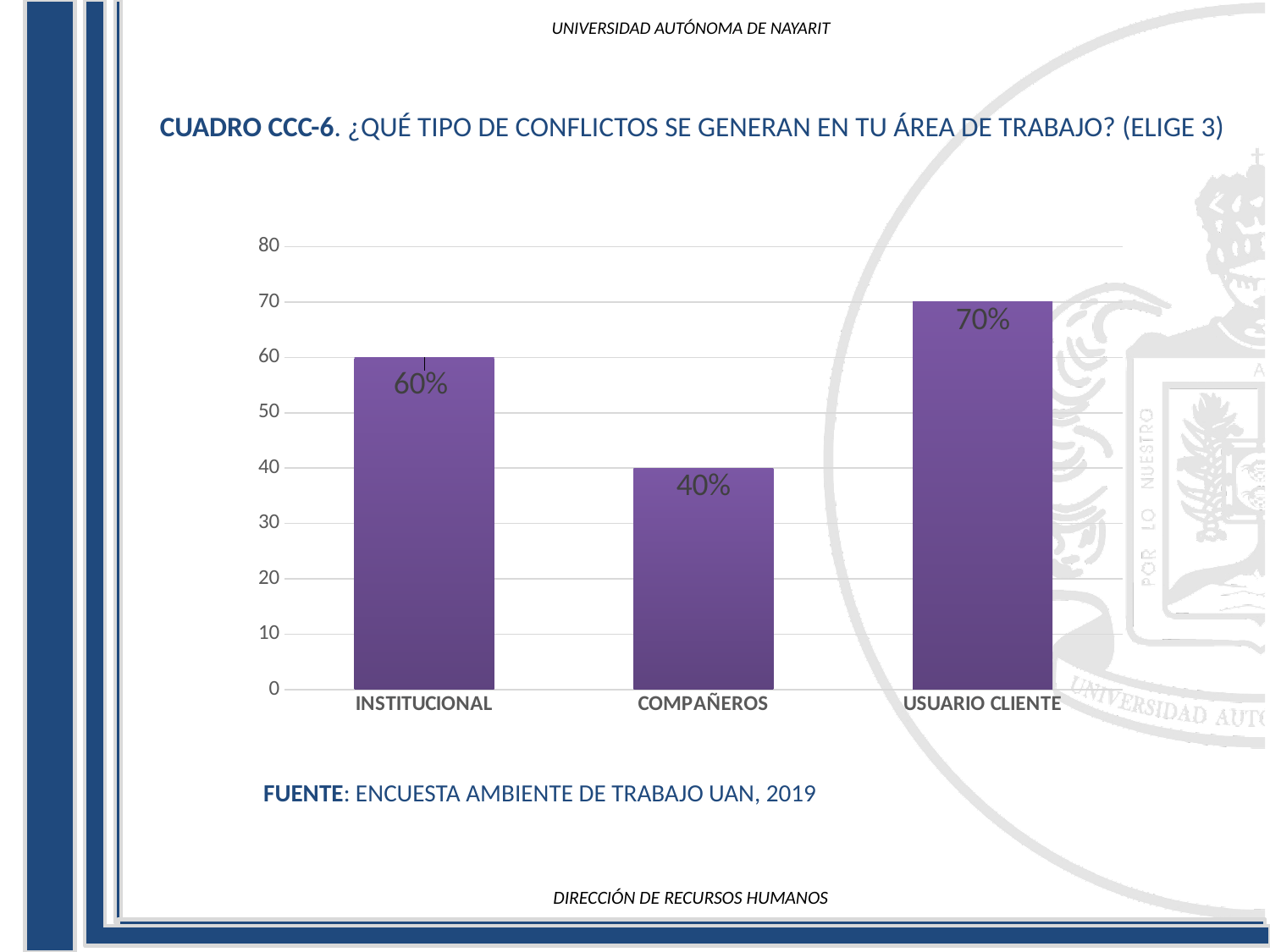
What is the value for COMPAÑEROS? 40% What is the value for INSTITUCIONAL? 60% How many categories are shown on the x axis? 3 What source is cited below the chart? ENCUESTA AMBIENTE DE TRABAJO UAN, 2019 Which category has the lowest value? COMPAÑEROS What kind of chart is shown on the slide? bar chart Which is larger, the value for INSTITUCIONAL or the value for USUARIO CLIENTE? USUARIO CLIENTE What is the difference between the values for INSTITUCIONAL and COMPAÑEROS? 20% Which category has the highest value? USUARIO CLIENTE What is the difference between the values for USUARIO CLIENTE and COMPAÑEROS? 30% What is the value for USUARIO CLIENTE? 70% Is the value for COMPAÑEROS greater or less than 50? less